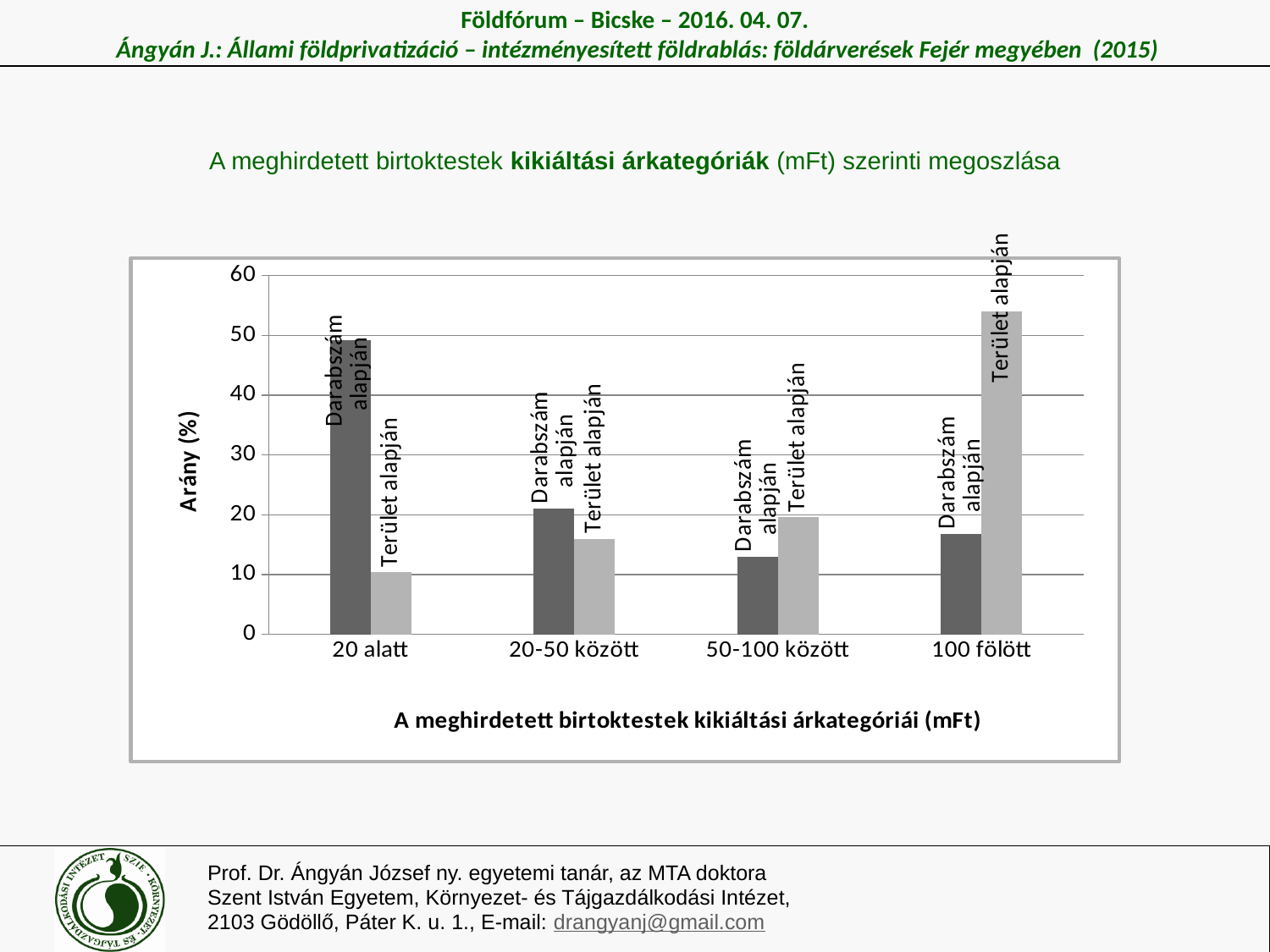
In the '100 fölött' category, which series has the larger value, 'Darabszám alapján' or 'Terület alapján'? Terület alapján Is the 'Darabszám alapján' value for '20 alatt' greater or less than 40? greater Is the 'Terület alapján' value for '100 fölött' greater or less than 50? greater What is the title of the vertical axis? Arány (%) Which price category has the highest value for the 'Darabszám alapján' series? 20 alatt How many data series are plotted in the chart? 2 Which price category has the lowest value for the 'Terület alapján' series? 20 alatt Is the 'Terület alapján' value for '20 alatt' greater or less than 20? less Which price category has the lowest value for the 'Darabszám alapján' series? 50-100 között How many price categories are shown on the x axis? 4 What kind of chart is shown on the slide? bar chart Which price category has the highest value for the 'Terület alapján' series? 100 fölött